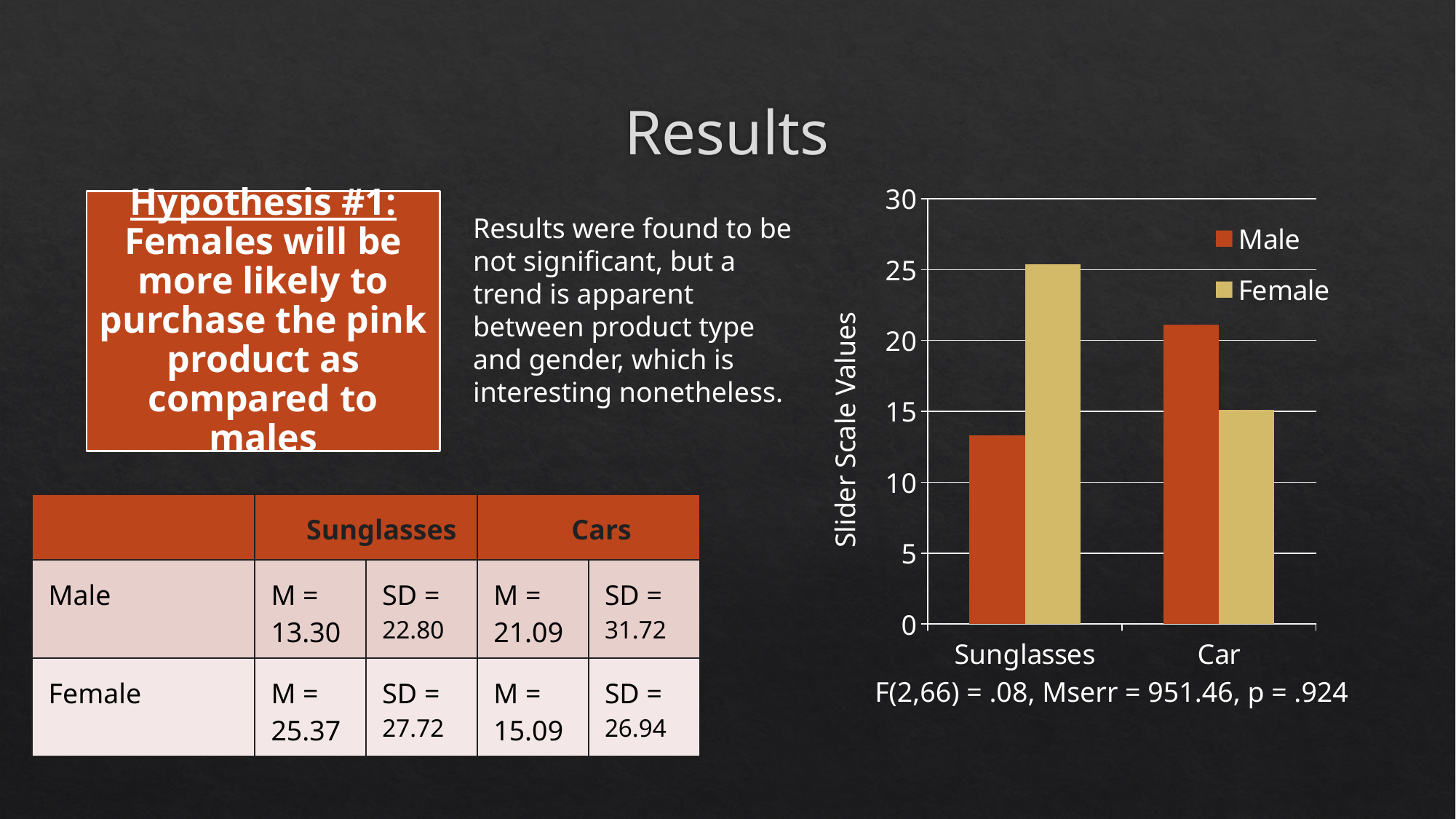
How many series does the chart legend list? 2 For Car, which series has the larger value, Male or Female? Male How many product categories are shown on the x axis of the chart? 2 Is the Female value for Sunglasses greater or less than 20? greater For Sunglasses, which series has the larger value, Male or Female? Female What kind of chart is shown on the slide? bar chart Which bar in the chart is the highest? Female, Sunglasses Is the Male value for Sunglasses greater or less than 15? less What is the label of the chart's y axis? Slider Scale Values Which series is shown in the yellow/tan colour in the chart? Female Is the Female value for Car greater or less than 20? less Which bar in the chart is the lowest? Male, Sunglasses